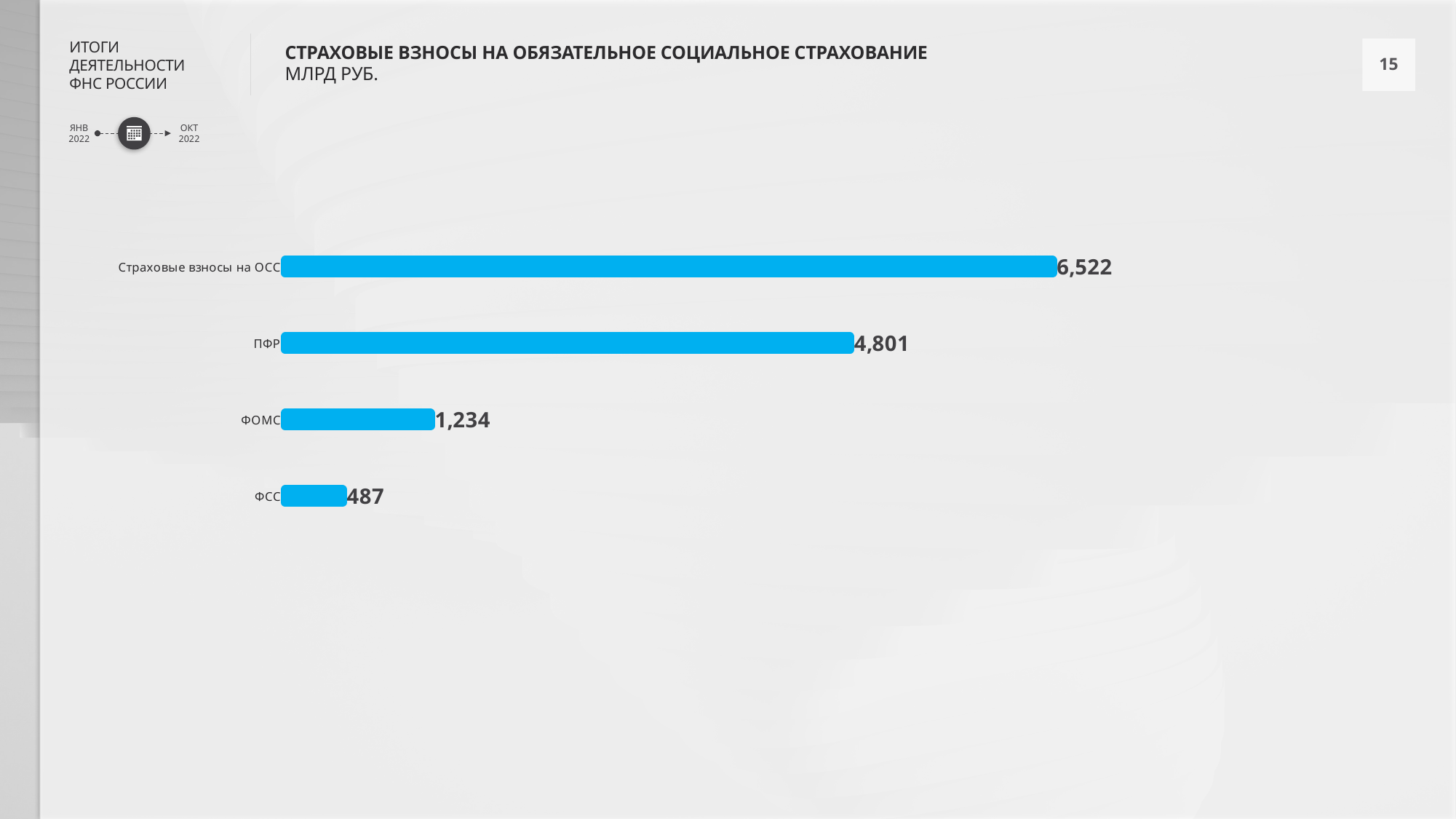
What is the difference between the values for Страховые взносы на ОСС and ПФР? 1,721 Which is larger, the value for ФОМС or the value for ФСС? ФОМС What is the value for ПФР? 4,801 What unit is stated under the chart title? МЛРД РУБ. How many categories are shown in the chart? 4 Which category has the highest value? Страховые взносы на ОСС What is the value for Страховые взносы на ОСС? 6,522 What is the difference between the values for ПФР and ФОМС? 3,567 What kind of chart is shown on the slide? Bar chart What is the value for ФСС? 487 What is the value for ФОМС? 1,234 Which category has the lowest value? ФСС